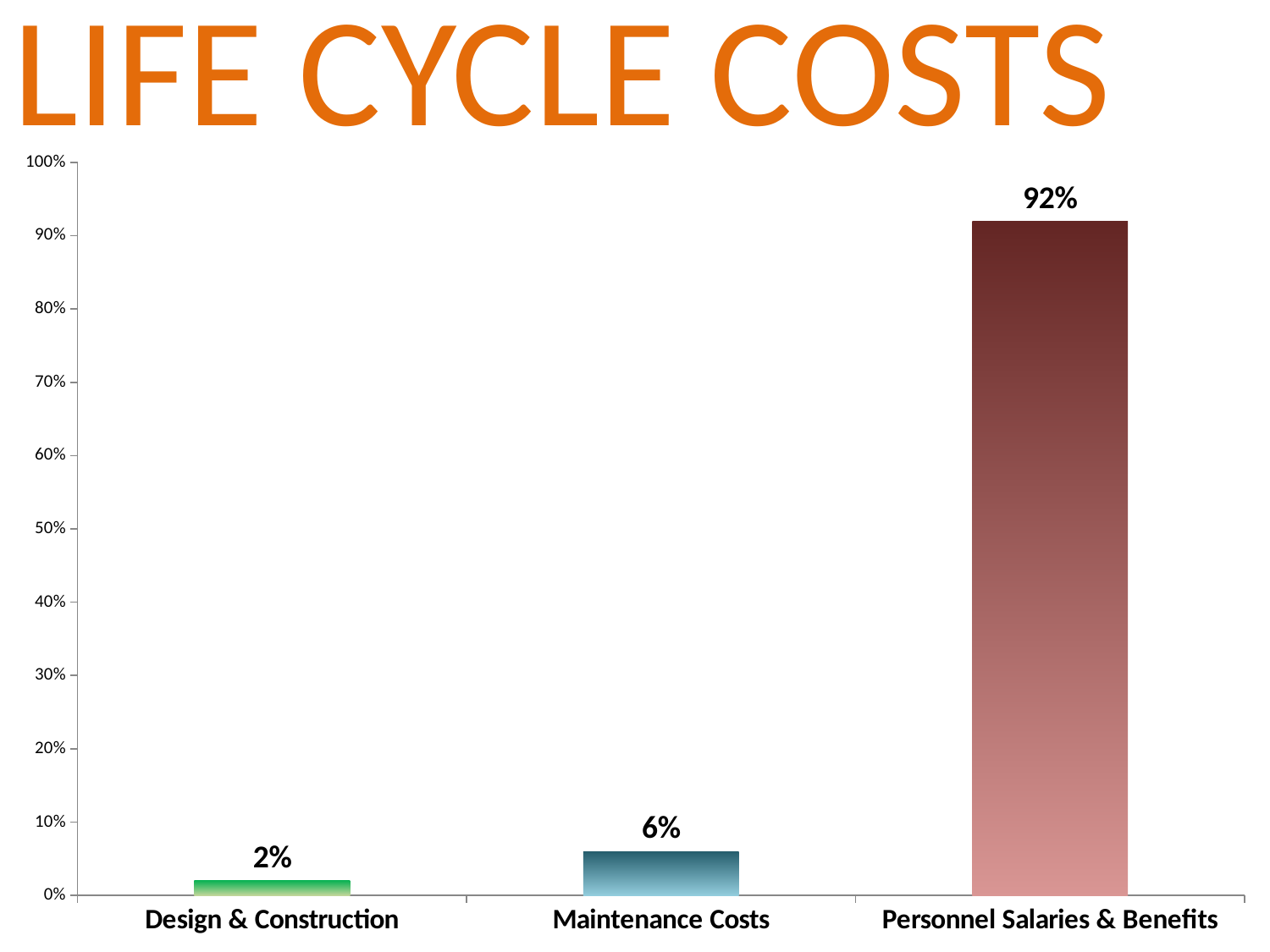
How many categories are shown on the x axis? 3 What is the difference between the values for Maintenance Costs and Design & Construction? 4% What is the difference between the values for Personnel Salaries & Benefits and Maintenance Costs? 86% What is the title of the slide? LIFE CYCLE COSTS What is the value for Personnel Salaries & Benefits? 92% Which category has the lowest value? Design & Construction What kind of chart is shown on the slide? bar chart Which category has the highest value? Personnel Salaries & Benefits Is the value for Personnel Salaries & Benefits greater or less than 90%? greater What is the value for Design & Construction? 2% Which is larger, the value for Maintenance Costs or the value for Design & Construction? Maintenance Costs What is the value for Maintenance Costs? 6%